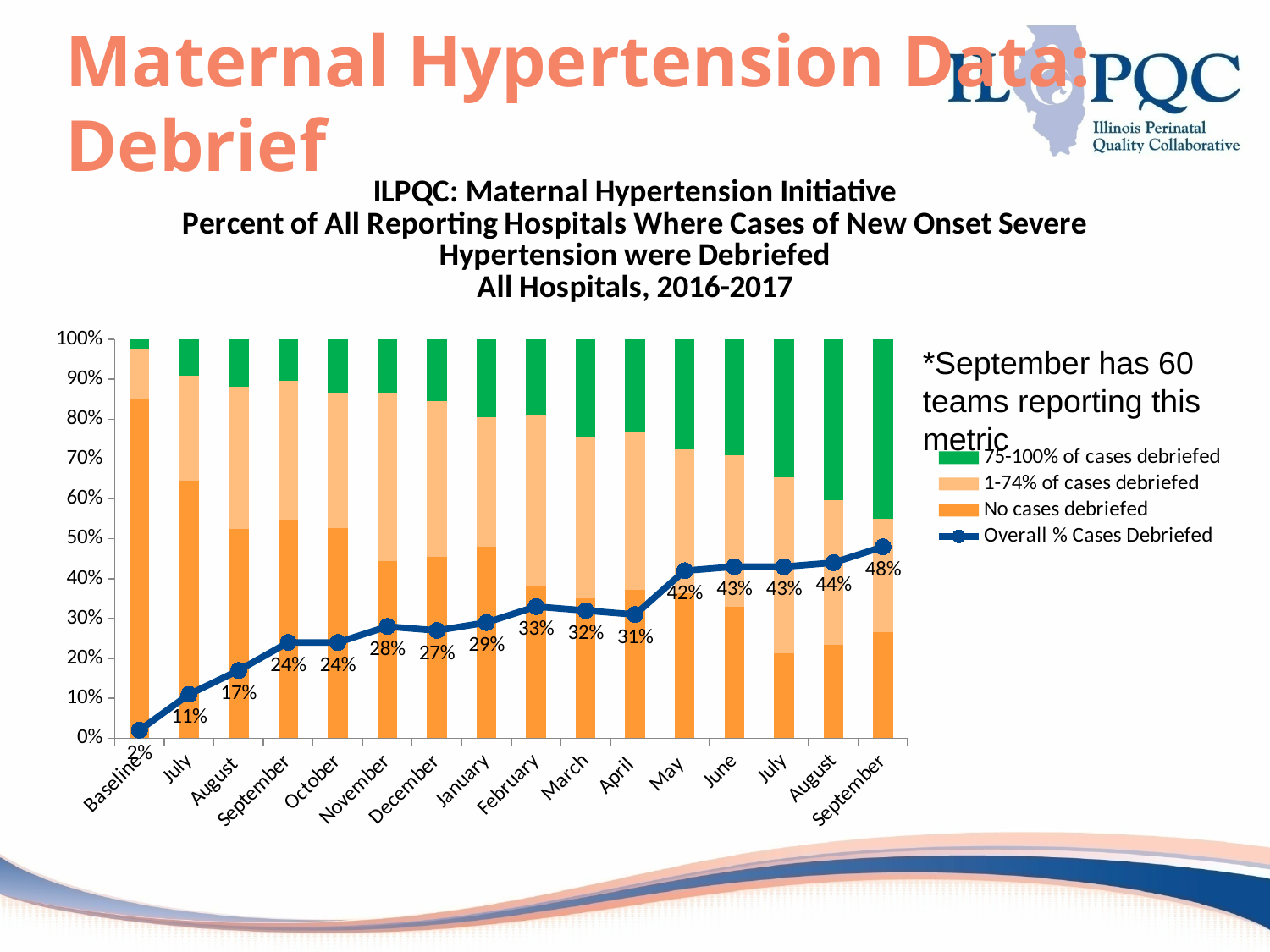
Which period has the highest Overall % Cases Debriefed? September (the rightmost, final period) Which period has the lowest Overall % Cases Debriefed? Baseline Does the Overall % Cases Debriefed line generally rise or fall from Baseline to the final September? Rise What is the Overall % Cases Debriefed value for May? 42% Which has a higher Overall % Cases Debriefed, February or March? February How many time periods are shown on the x axis? 16 Is the 'No cases debriefed' share of the Baseline bar greater or less than 80%? greater How many entries does the legend list? 4 What is the Overall % Cases Debriefed value at Baseline? 2% By how many percentage points did the Overall % Cases Debriefed increase from Baseline to the final September? 46 percentage points By how many percentage points did the Overall % Cases Debriefed change from April to May? 11 percentage points What kind of chart is this? A stacked bar chart with a line overlay